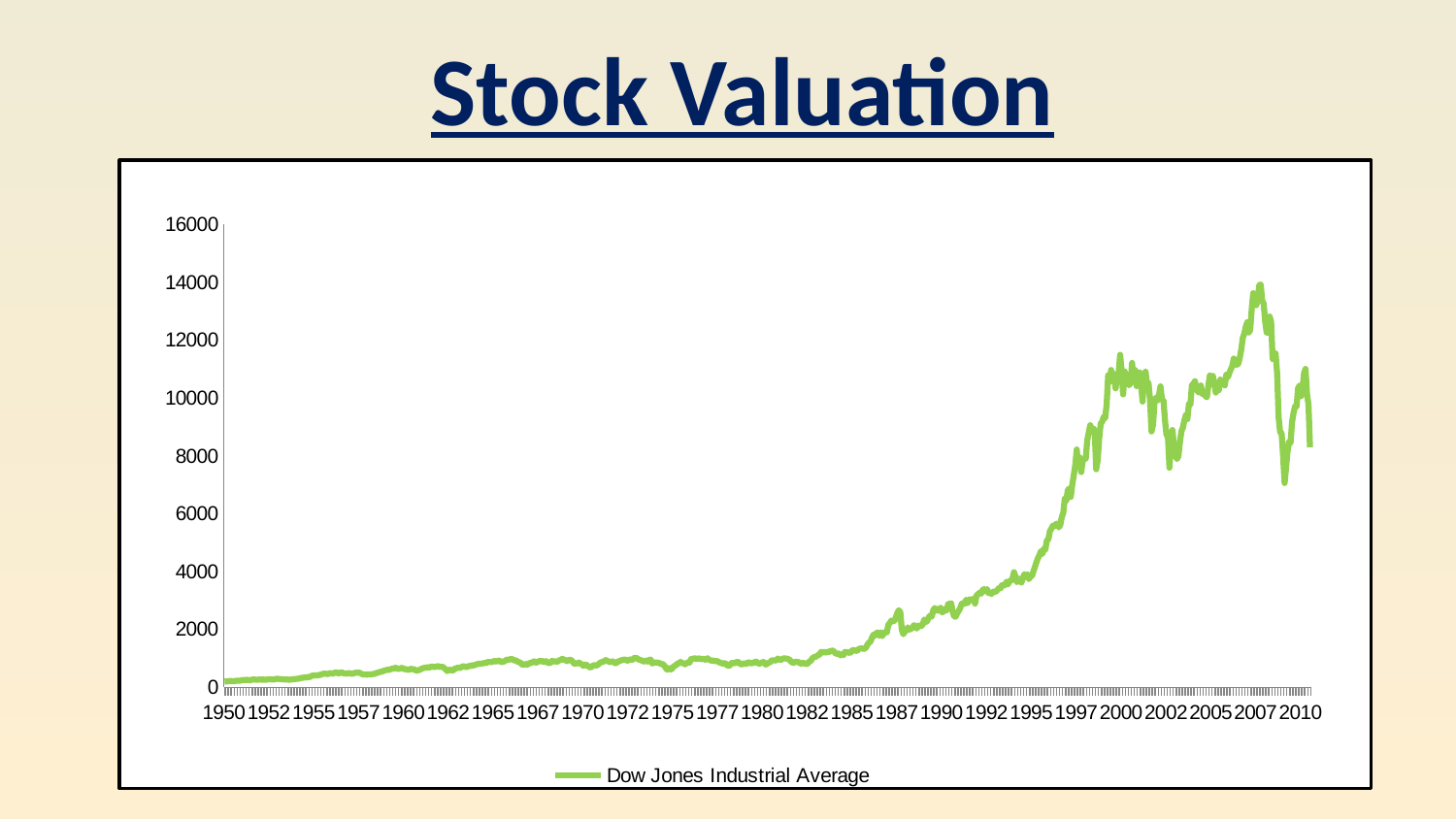
What series name appears in the chart legend? Dow Jones Industrial Average Is the peak value of the Dow Jones Industrial Average around 2007 greater or less than 12000? greater What kind of chart is shown on the slide? line chart What is the title of the slide containing the chart? Stock Valuation Is the value of the Dow Jones Industrial Average in 1985 greater or less than 4000? less Around which labelled year does the Dow Jones Industrial Average reach its highest value? 2007 How many series does the legend list? 1 Is the value of the Dow Jones Industrial Average in 1950 greater or less than 2000? less Which is larger, the Dow Jones Industrial Average in 1960 or in 2000? 2000 Overall, does the Dow Jones Industrial Average rise or fall from 1950 to 2010? rise